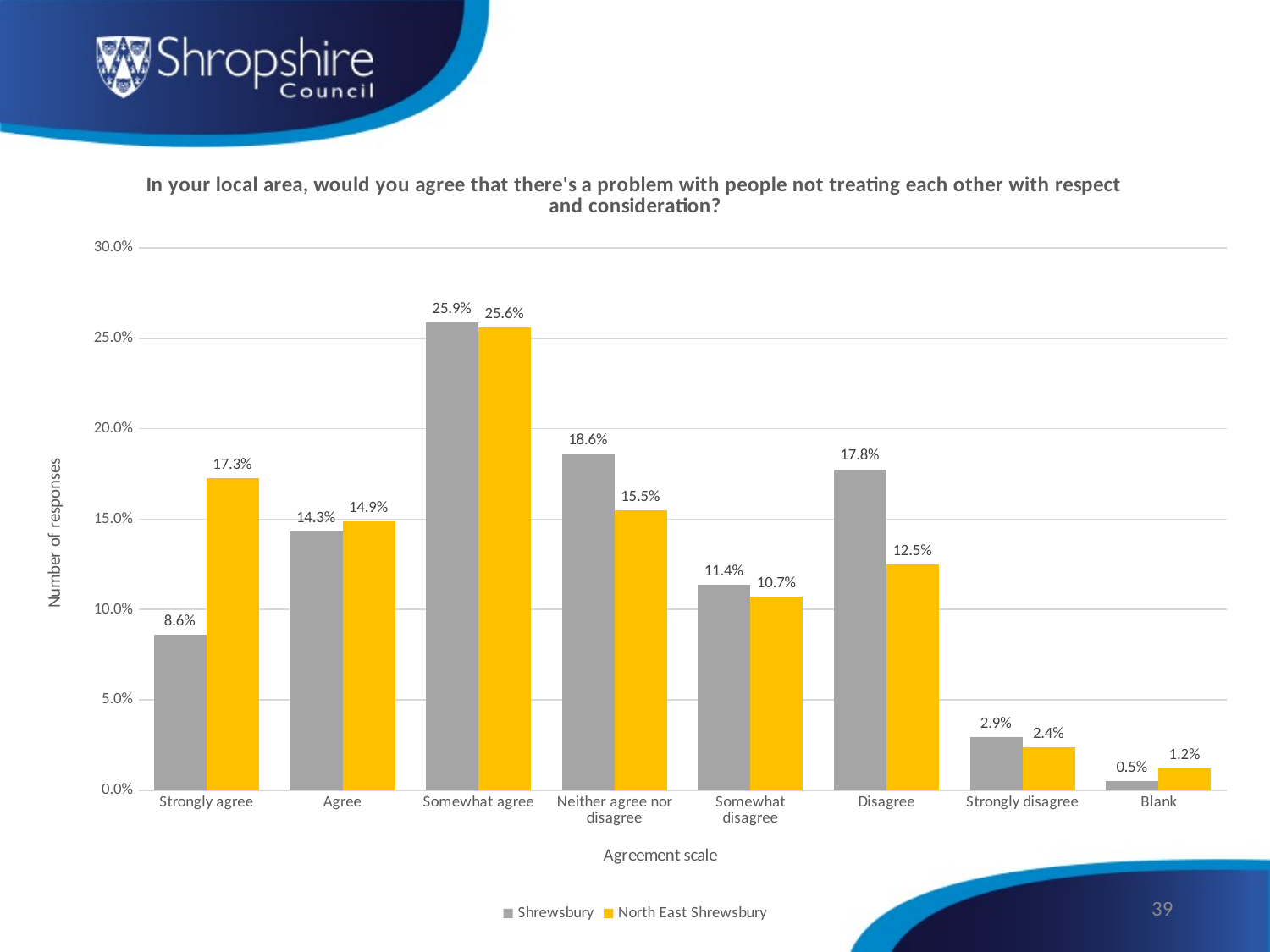
Is the value for Shrewsbury in the Neither agree nor disagree category greater or less than 15.0%? greater What kind of chart is shown on the slide? Bar chart Which category has the lowest value for North East Shrewsbury? Blank Which category has the highest value for Shrewsbury? Somewhat agree Which is larger in the Disagree category, Shrewsbury or North East Shrewsbury? Shrewsbury What is the difference between the Shrewsbury and North East Shrewsbury values for Strongly agree? 8.7% What is the value for North East Shrewsbury in the Disagree category? 12.5% What is the value for Shrewsbury in the Strongly agree category? 8.6% How many categories are shown on the x axis? 8 What is the label of the x axis? Agreement scale How many series does the legend list? 2 What is the value for North East Shrewsbury in the Blank category? 1.2%